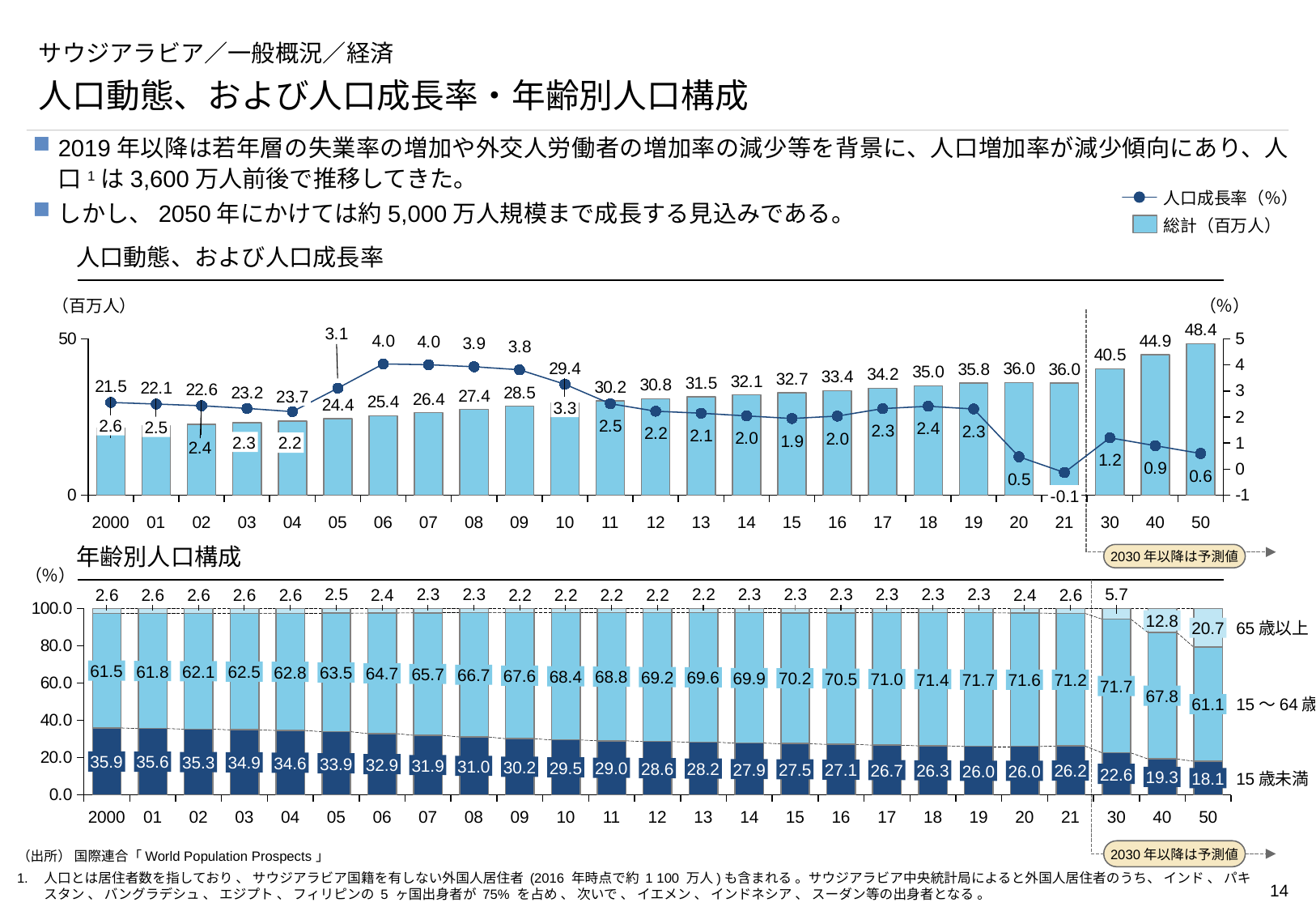
In the top chart (人口動態、および人口成長率), what is the population growth rate (%) shown for 2021? -0.1 In the top chart (人口動態、および人口成長率), which year has the lowest population growth rate? 2021 In the top chart (人口動態、および人口成長率), which year has the higher population growth rate, 2005 or 2011? 2005 In the top chart (人口動態、および人口成長率), which year has the highest total population? 2050 What kind of chart is the bottom chart (年齢別人口構成)? Stacked bar chart In the bottom chart (年齢別人口構成), what is the share of 15歳未満 in 2000? 35.9 In the bottom chart (年齢別人口構成), what is the share of 65歳以上 in 2050? 20.7 In the bottom chart (年齢別人口構成), does the share of 15歳未満 rise or fall from 2000 to 2050? Fall In the top chart (人口動態、および人口成長率), what is the total population (百万人) shown for 2010? 29.4 In the top chart (人口動態、および人口成長率), what is the difference between the total population in 2050 and in 2021? 12.4 In the top chart (人口動態、および人口成長率), how many years are shown on the x axis? 25 How many series does the legend for the top chart list? 2